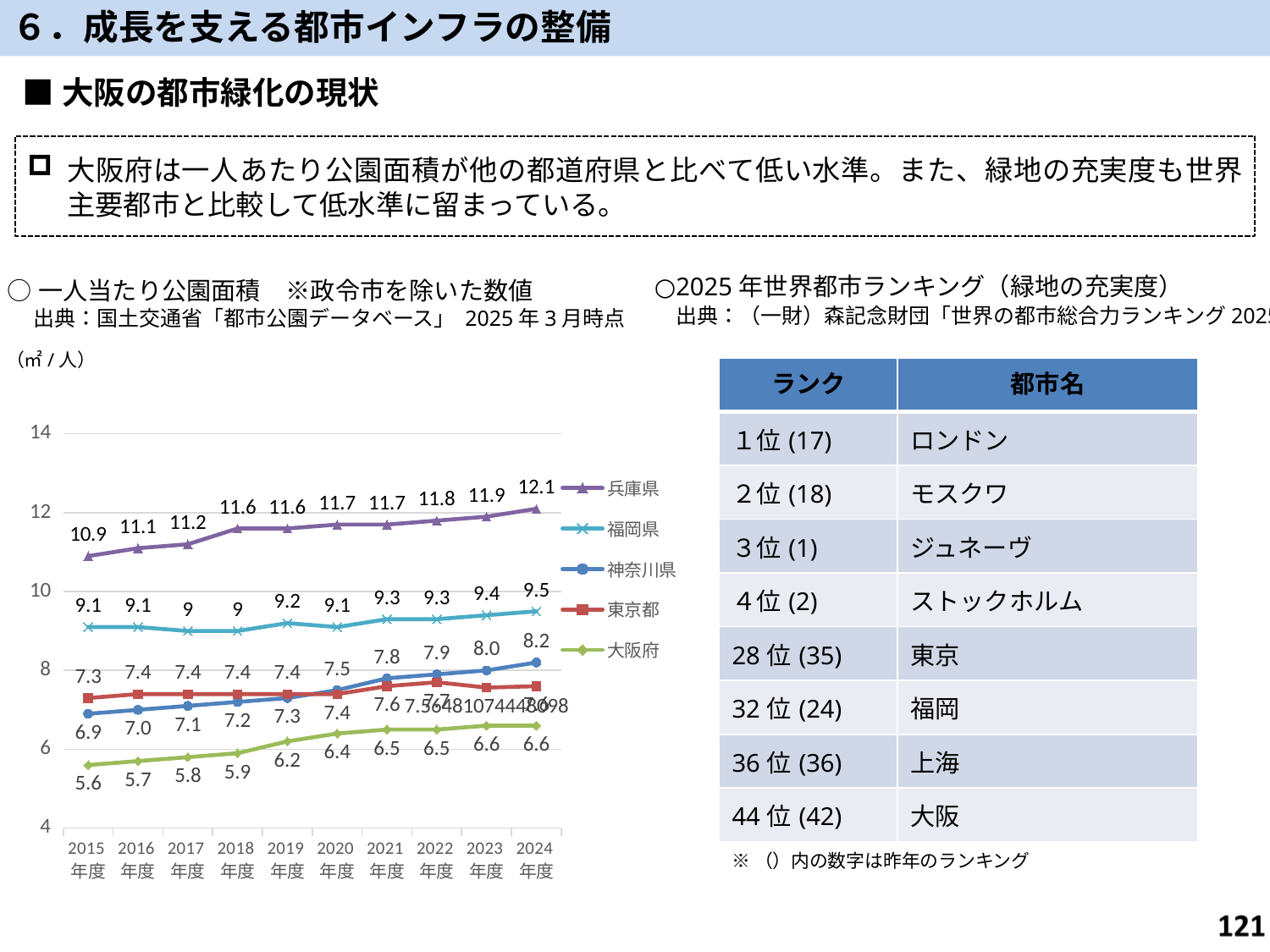
In 2015年度, which is larger in the 一人当たり公園面積 chart: 東京都 or 神奈川県? 東京都 How many series does the legend of the 一人当たり公園面積 chart list? 5 How many fiscal years are plotted on the x axis of the 一人当たり公園面積 chart? 10 Which prefecture has the highest value in 2024年度 in the 一人当たり公園面積 chart? 兵庫県 What is the value for 兵庫県 in 2024年度 in the 一人当たり公園面積 chart? 12.1 What is the difference between 兵庫県 and 大阪府 in 2024年度 in the 一人当たり公園面積 chart? 5.5 Does the value for 大阪府 rise or fall from 2015年度 to 2024年度 in the 一人当たり公園面積 chart? rise What is the value for 神奈川県 in 2021年度 in the 一人当たり公園面積 chart? 7.8 Which prefecture has the lowest value in 2024年度 in the 一人当たり公園面積 chart? 大阪府 What is the value for 大阪府 in 2015年度 in the 一人当たり公園面積 chart? 5.6 What unit is shown above the y axis of the 一人当たり公園面積 chart? ㎡/人 What type of chart is used to show 一人当たり公園面積? line chart